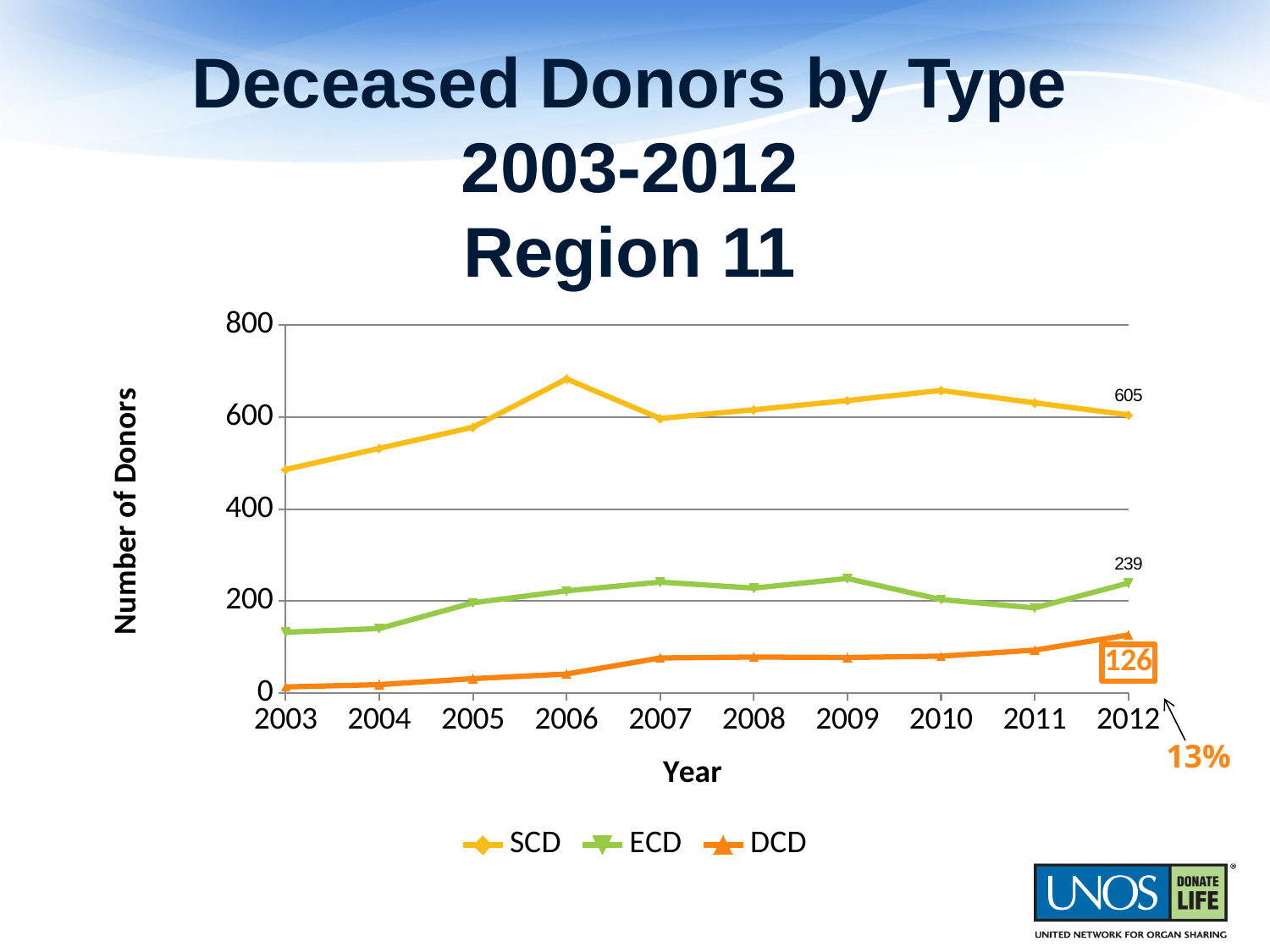
Is the value for DCD in 2007 greater or less than 200? less What is the value for ECD in 2012? 239 How many years are shown on the x axis? 10 What is the value for DCD in 2012? 126 In which year is the DCD value lowest? 2003 What is the value for SCD in 2012? 605 What kind of chart is shown on the slide? line chart How many series does the legend list? 3 Which series has the highest value in 2012? SCD What is the difference between the ECD and DCD values in 2012? 113 Is the value for SCD in 2003 greater or less than 400? greater What is the difference between the SCD and ECD values in 2012? 366